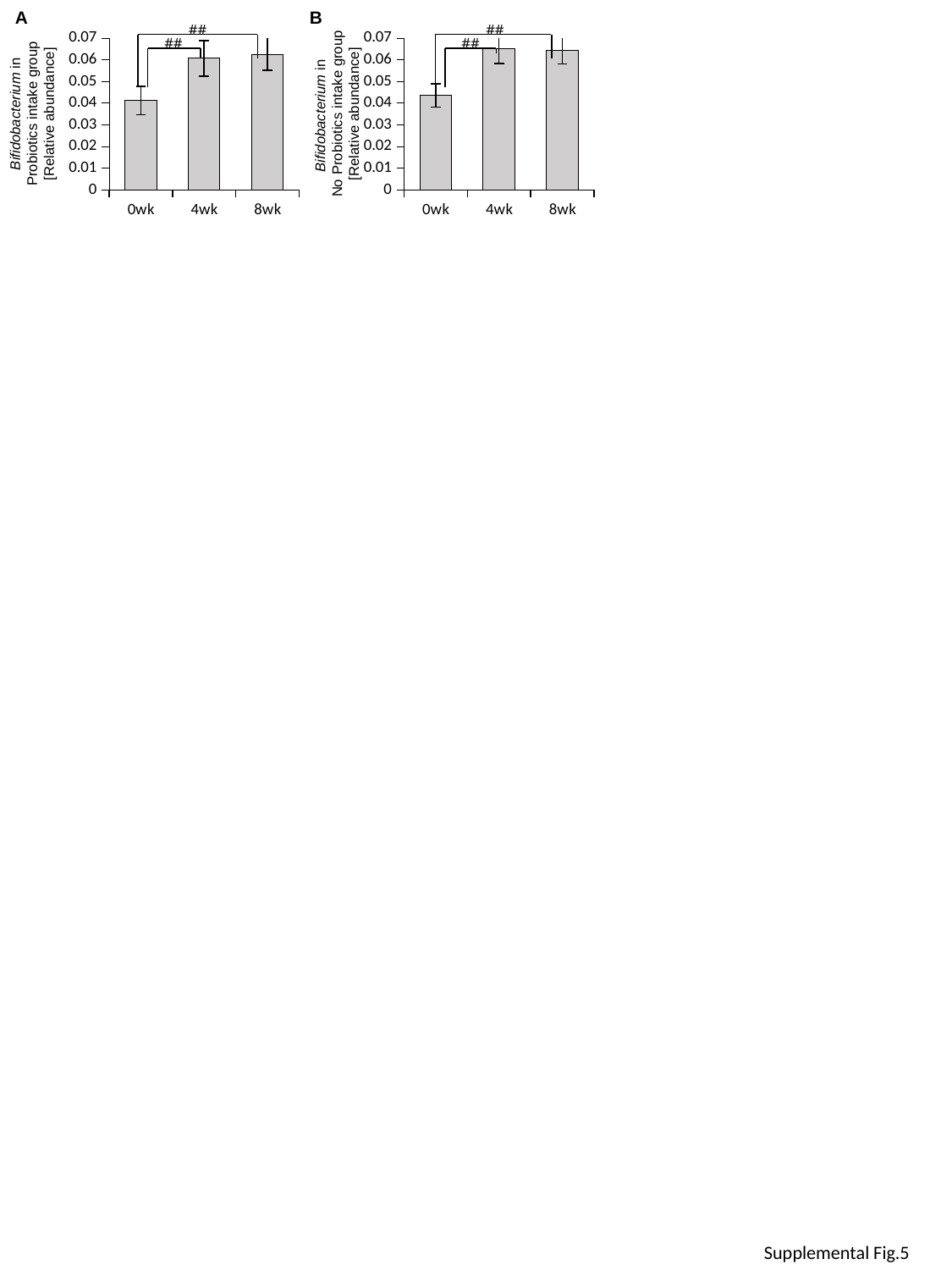
In chart B (right), is the value for 0wk greater or less than 0.05? less In chart A (left), what is the label of the y axis? Bifidobacterium in Probiotics intake group [Relative abundance] In chart A (left), is the value for 0wk greater or less than 0.05? less In chart A (left), what kind of chart is shown? bar chart In chart A (left), is the value for 4wk greater or less than 0.05? greater In chart A (left), how many time-point categories are shown on the x axis? 3 In chart B (right), which time point has the lowest Bifidobacterium relative abundance? 0wk In chart B (right), which is larger, the value for 0wk or the value for 4wk? 4wk In chart A (left), which is larger, the value for 0wk or the value for 8wk? 8wk In chart A (left), which time point has the lowest Bifidobacterium relative abundance? 0wk In chart B (right), what is the highest tick value shown on the y axis? 0.07